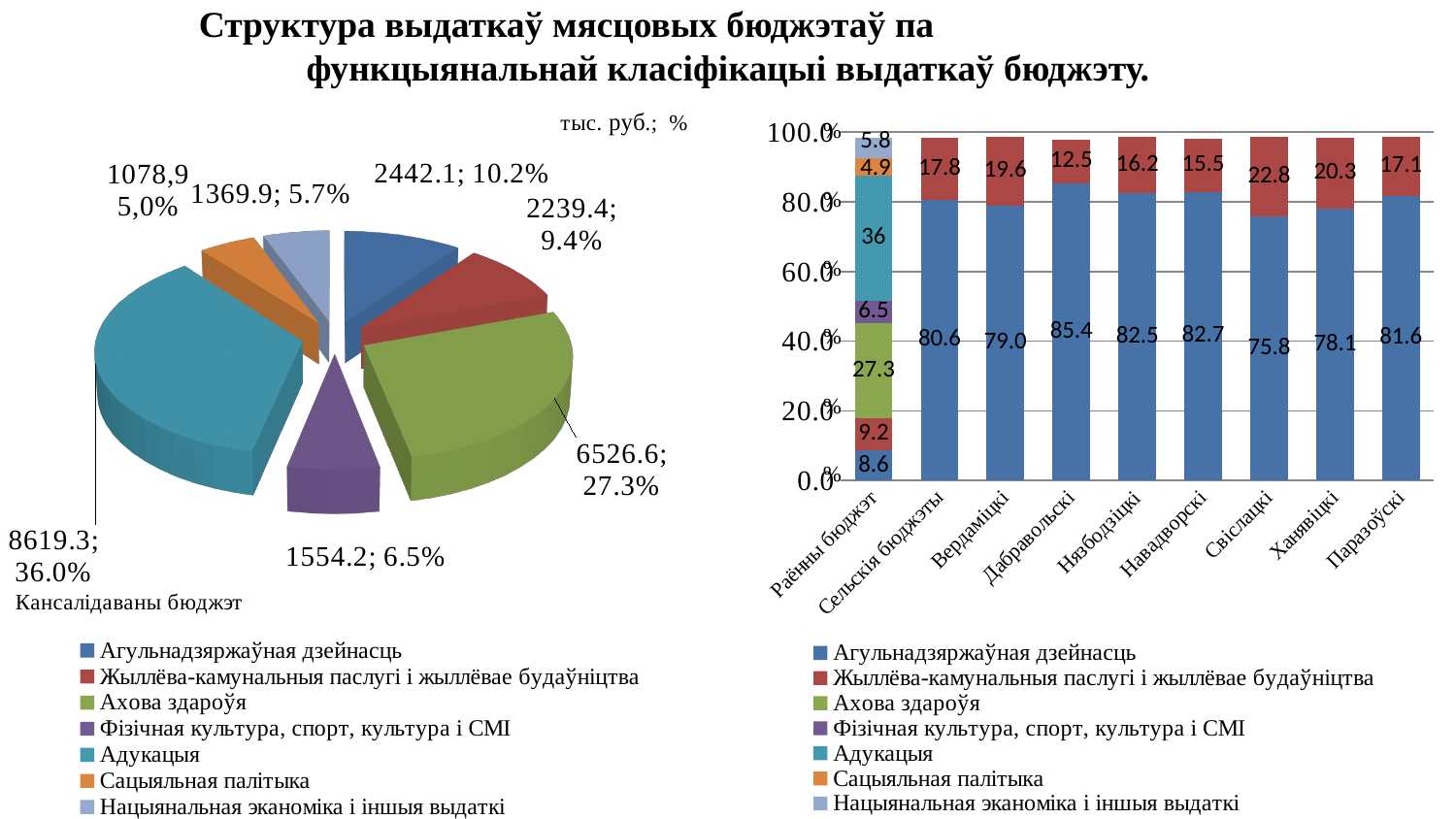
In the bar chart on the right, what is the value of Жыллёва-камунальныя паслугі і жыллёвае будаўніцтва for Свіслацкі? 22.8 In the bar chart on the right, how many categories are shown on the x axis? 9 In the pie chart on the left, how many slices are there? 7 In the bar chart on the right, which category has the lowest value for Агульнадзяржаўная дзейнасць? Раённы бюджэт In the bar chart on the right, how many series does the legend list? 7 In the pie chart on the left, what value is shown for Ахова здароўя? 6526.6 In the pie chart on the left, which category has the smallest slice? Сацыяльная палітыка In the bar chart on the right, which category has the highest value for Агульнадзяржаўная дзейнасць? Дабравольскі In the pie chart on the left, which category has the largest slice? Адукацыя In the bar chart on the right, what is the value of Агульнадзяржаўная дзейнасць for Дабравольскі? 85.4 In the pie chart on the left, what share does Адукацыя have? 36.0% In the bar chart on the right, what is the difference between the Агульнадзяржаўная дзейнасць values for Дабравольскі and Свіслацкі? 9.6